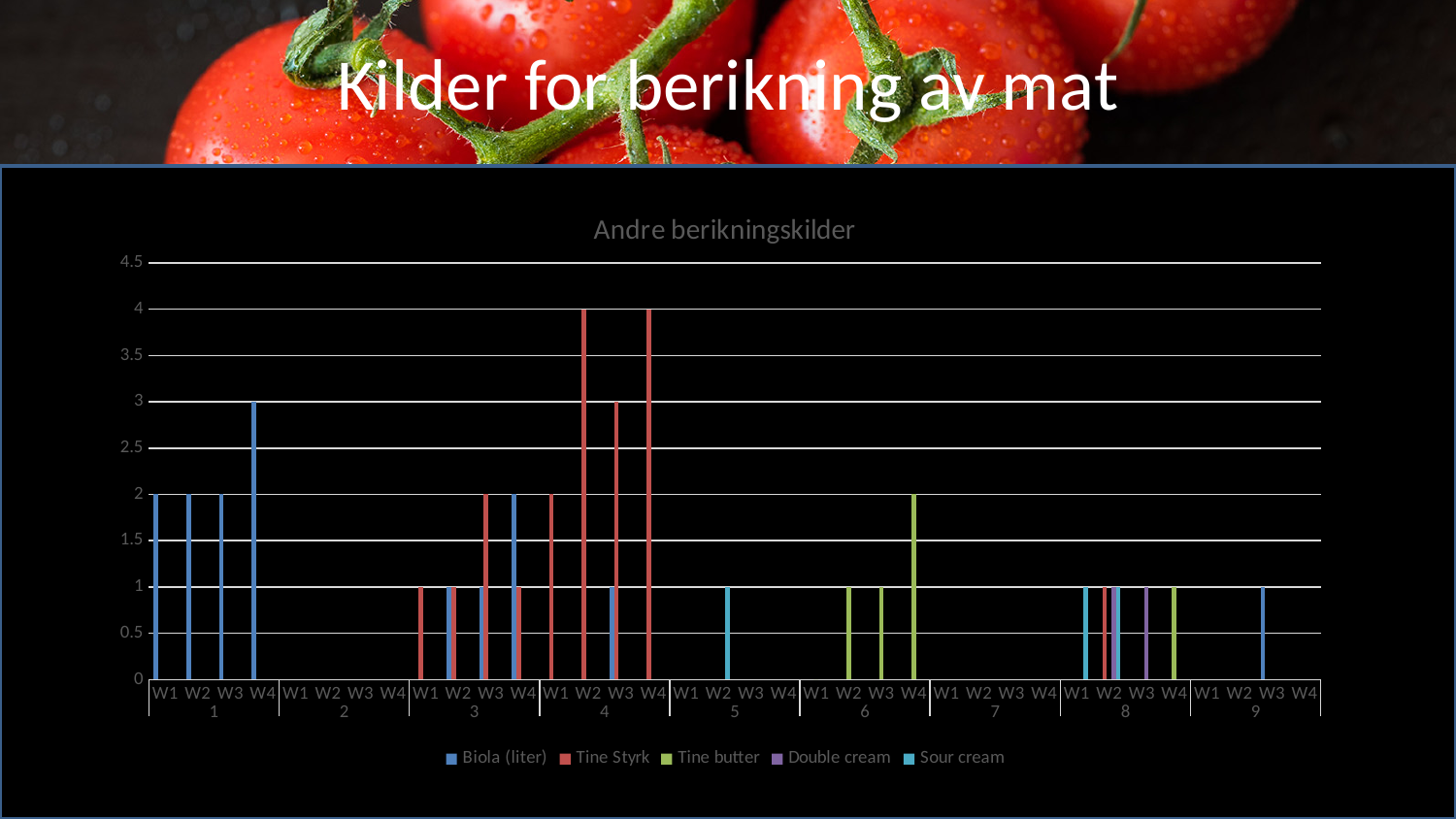
How many numbered groups are shown along the x axis? 9 How many series does the legend of the chart list? 5 What is the value of Tine butter in W4 of group 6? 2 What is the difference between Tine Styrk in W2 of group 4 and Biola (liter) in W4 of group 1? 1 What is the value of Tine Styrk in W3 of group 4? 3 Which series is shown in green in the legend? Tine butter What is the value of Biola (liter) in W4 of group 1? 3 What type of chart is shown on the slide? bar chart Which is larger: Tine Styrk in W2 of group 4 or Biola (liter) in W4 of group 1? Tine Styrk in W2 of group 4 What is the title of the chart? Andre berikningskilder What is the highest value reached by any bar in the chart? 4 Which series reaches the highest value in the chart? Tine Styrk